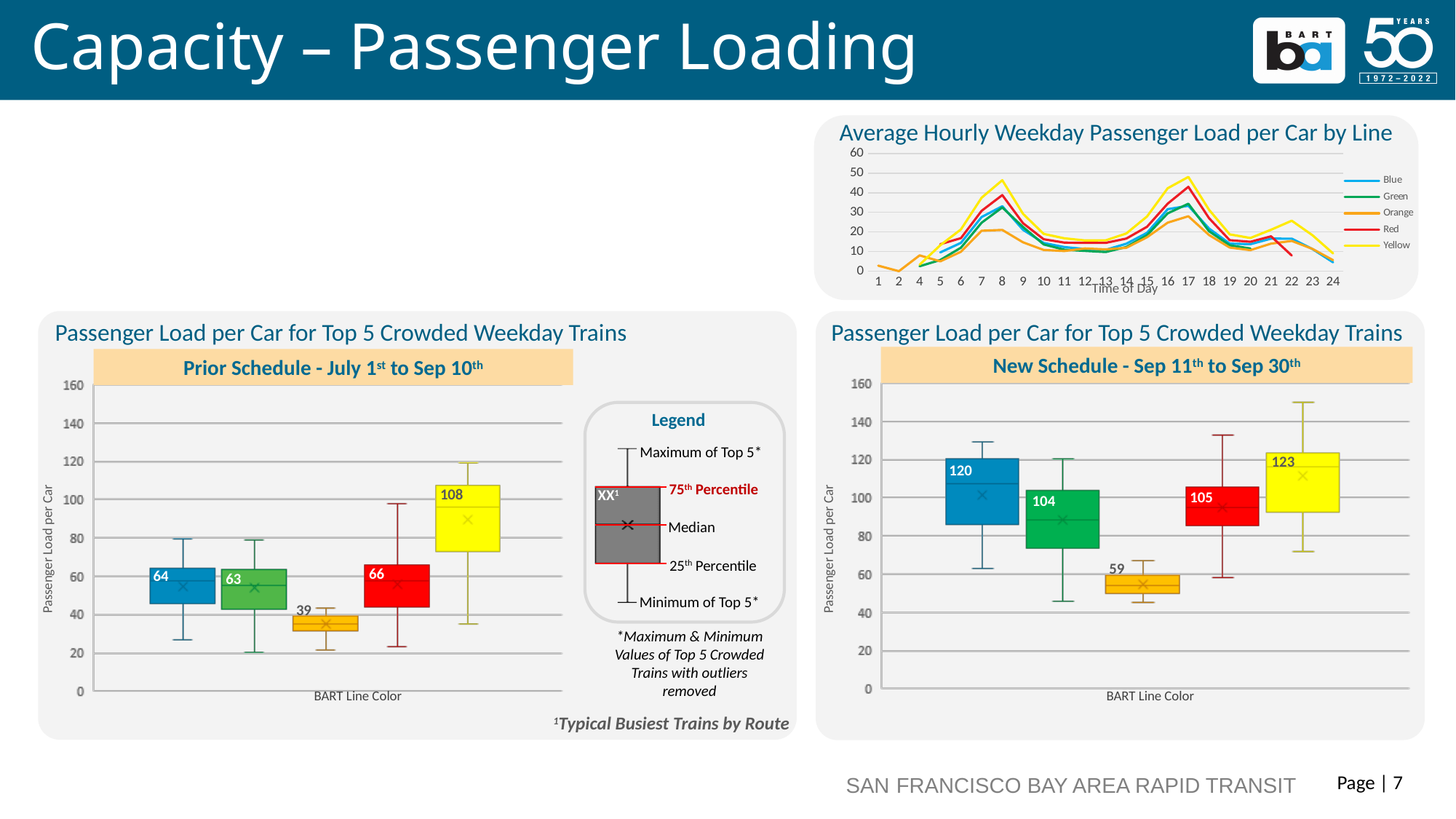
In the 'Average Hourly Weekday Passenger Load per Car by Line' chart, is the Yellow line's value at hour 17 greater or less than 40? greater In the 'New Schedule - Sep 11th to Sep 30th' chart, which line has the lowest labelled value? Orange What is the difference between the labelled value for the yellow line in the New Schedule chart (123) and in the Prior Schedule chart (108)? 15 How many series does the legend of the 'Average Hourly Weekday Passenger Load per Car by Line' chart list? 5 In the 'Prior Schedule - July 1st to Sep 10th' chart, what is the labelled value for the orange line? 39 Is the labelled value for the green line larger in the Prior Schedule chart or the New Schedule chart? New Schedule In the 'Prior Schedule - July 1st to Sep 10th' chart, what is the labelled value for the yellow line? 108 In the 'New Schedule - Sep 11th to Sep 30th' chart, what is the labelled value for the blue line? 120 In the 'New Schedule - Sep 11th to Sep 30th' chart, which line has the highest labelled value? Yellow What kind of chart is 'Average Hourly Weekday Passenger Load per Car by Line'? Line chart What is the x-axis label of the 'Average Hourly Weekday Passenger Load per Car by Line' chart? Time of Day In the 'Prior Schedule - July 1st to Sep 10th' chart, which line has the lowest labelled value? Orange